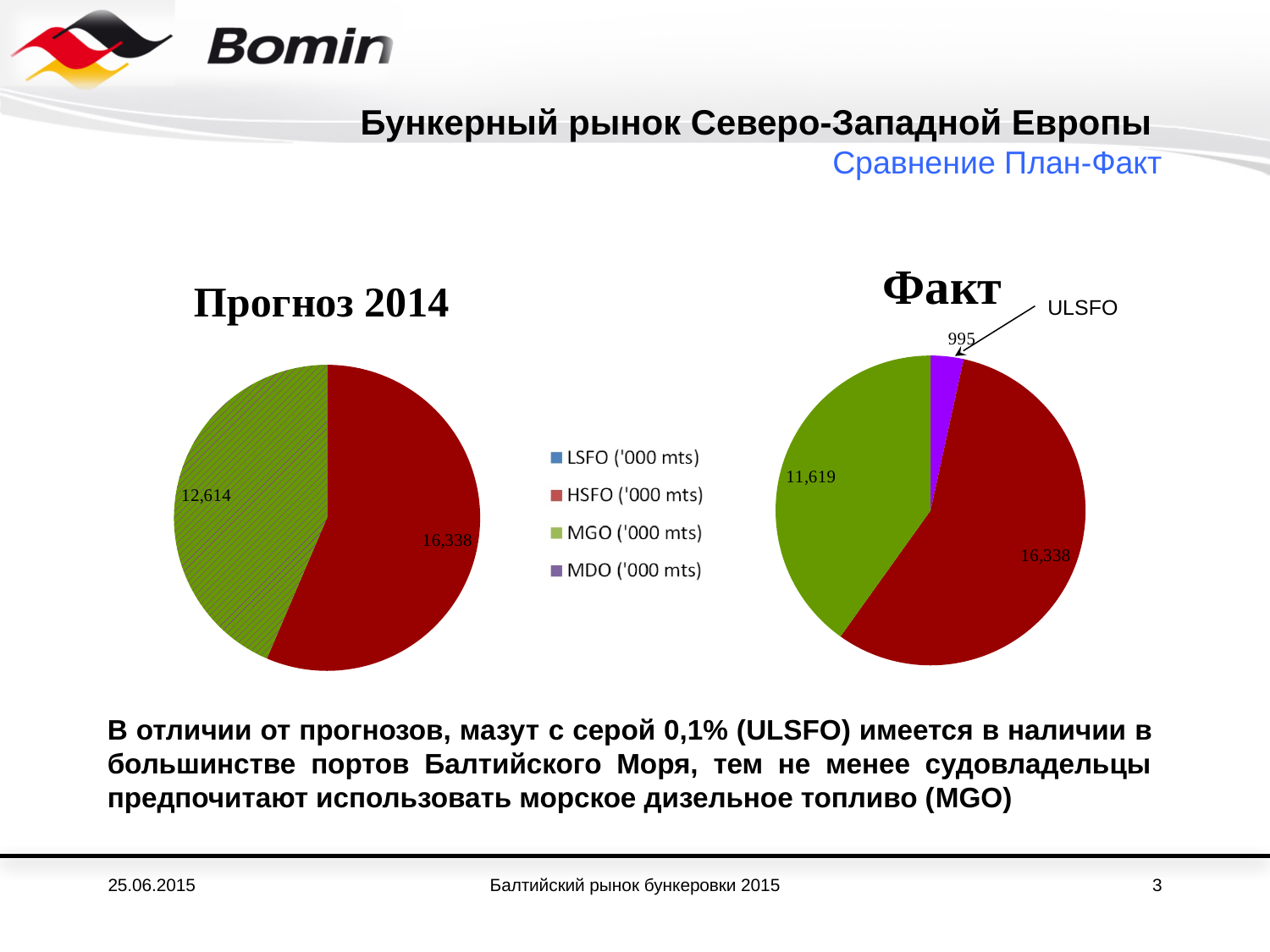
In the Факт chart, what is the value of the ULSFO slice? 995 In the Прогноз 2014 chart, what is the value of the MGO slice? 12,614 What kind of charts are shown on the slide? Pie charts In the Прогноз 2014 chart, which slice is the largest? HSFO How many slices does the Факт pie chart have? 3 In the Факт chart, what is the value of the MGO slice? 11,619 How many entries does the legend between the two charts list? 4 In the Прогноз 2014 chart, what is the value of the HSFO slice? 16,338 In the Факт chart, which is larger, HSFO or MGO? HSFO In the Прогноз 2014 chart, what is the difference between the HSFO and MGO values? 3,724 In the Факт chart, which slice is the smallest? ULSFO How much larger is the MGO value in the Прогноз 2014 chart than in the Факт chart? 995